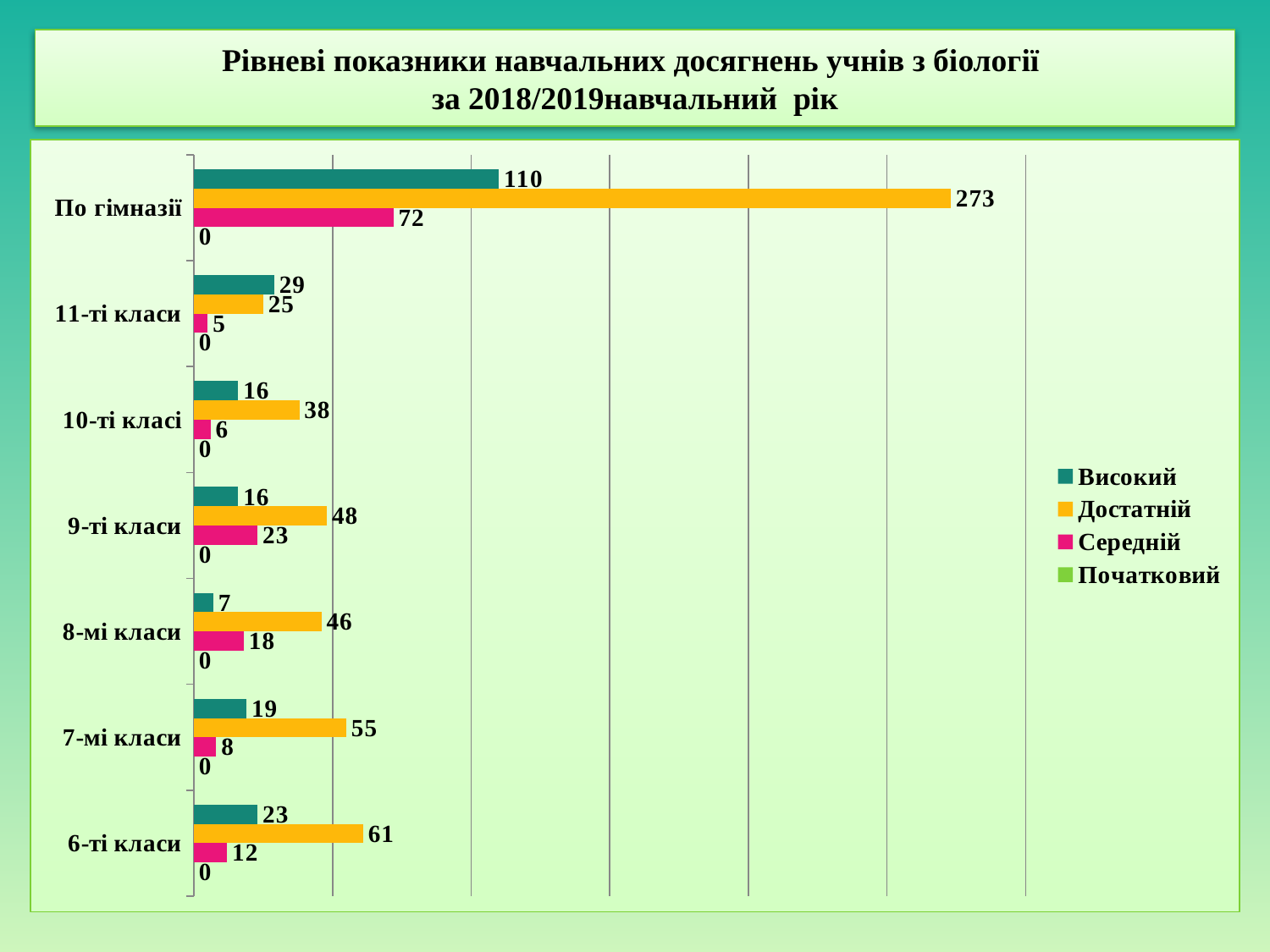
How many categories are shown on the vertical axis? 7 What is the value of Високий for 11-ті класи? 29 What is the value of Середній for 9-ті класи? 23 Which class category has the highest Достатній value, excluding По гімназії? 6-ті класи What kind of chart is shown on the slide? Bar chart What is the value of Початковий for 7-мі класи? 0 What is the value of Достатній for По гімназії? 273 Which is larger for 11-ті класи: Високий or Достатній? Високий How many series does the legend list? 4 Which category has the lowest Високий value? 8-мі класи What is the value of Достатній for 6-ті класи? 61 What is the difference between the Достатній and Високий values for По гімназії? 163